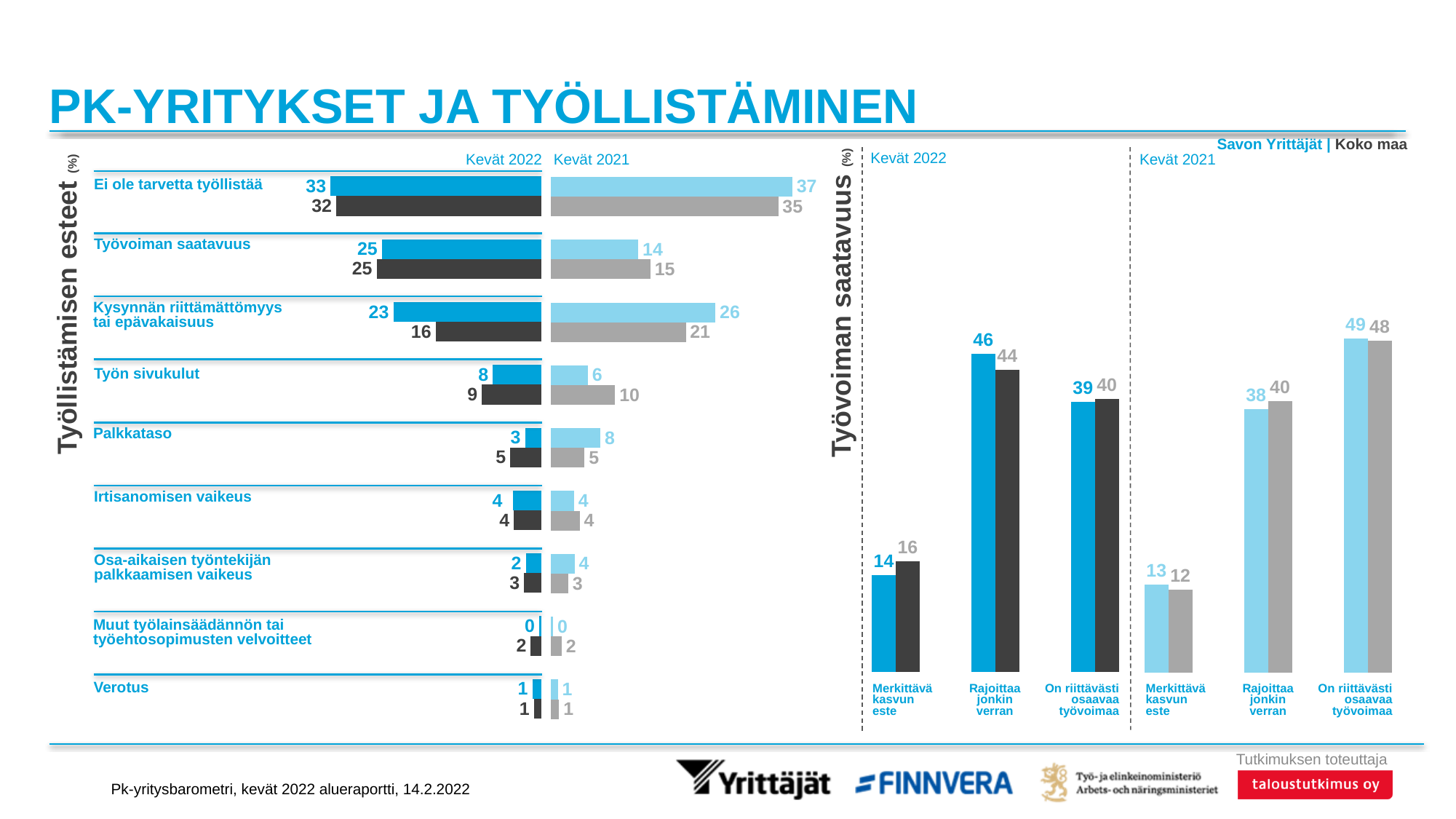
In the left chart (Työllistämisen esteet), what is the Kevät 2022 value for Savon Yrittäjät for 'Ei ole tarvetta työllistää'? 33 In the right chart (Työvoiman saatavuus), what is the Kevät 2022 value for Savon Yrittäjät for 'Rajoittaa jonkin verran'? 46 In the left chart (Työllistämisen esteet), what is the Kevät 2021 value for Koko maa for 'Työvoiman saatavuus'? 15 In the left chart (Työllistämisen esteet), for 'Työvoiman saatavuus', is the Savon Yrittäjät value higher in Kevät 2022 or Kevät 2021? Kevät 2022 What kind of chart is the right chart (Työvoiman saatavuus)? Bar chart In the left chart (Työllistämisen esteet), how many barrier categories are listed? 9 In the right chart (Työvoiman saatavuus), what is the Kevät 2021 value for Koko maa for 'On riittävästi osaavaa työvoimaa'? 48 In the right chart (Työvoiman saatavuus), which category has the lowest Kevät 2021 value for Savon Yrittäjät? Merkittävä kasvun este In the left chart (Työllistämisen esteet), what is the difference between the Savon Yrittäjät and Koko maa Kevät 2022 values for 'Kysynnän riittämättömyys tai epävakaisuus'? 7 In the left chart (Työllistämisen esteet), which category has the highest Kevät 2022 value for Savon Yrittäjät? Ei ole tarvetta työllistää Which two groups are compared in the charts, as shown in the legend at the top right? Savon Yrittäjät and Koko maa In the right chart (Työvoiman saatavuus), what is the difference between the Savon Yrittäjät and Koko maa Kevät 2022 values for 'Merkittävä kasvun este'? 2